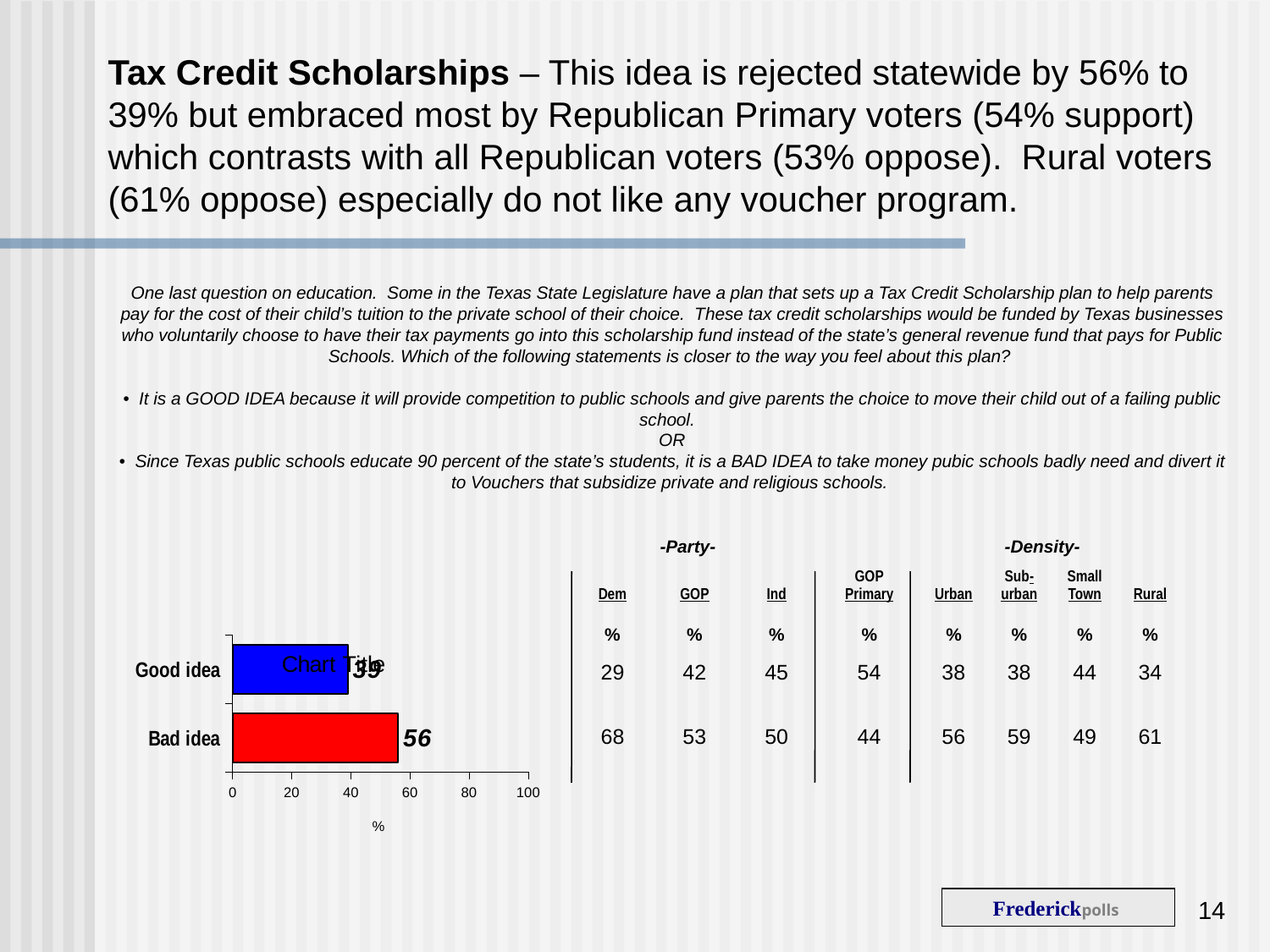
Which category has the highest value in the bar chart? Bad idea Is the value for Bad idea greater or less than 40? greater What kind of chart is shown on the slide? Bar chart Which is larger in the bar chart, Good idea or Bad idea? Bad idea What is the difference between the Bad idea and Good idea values in the bar chart? 17 What colour is the Bad idea bar in the chart? Red What is the highest tick value shown on the chart's horizontal axis? 100 Is the value for Good idea greater or less than 60? less What is the value for Good idea in the bar chart? 39 How many categories are shown in the bar chart? 2 Which category has the lowest value in the bar chart? Good idea What is the value for Bad idea in the bar chart? 56